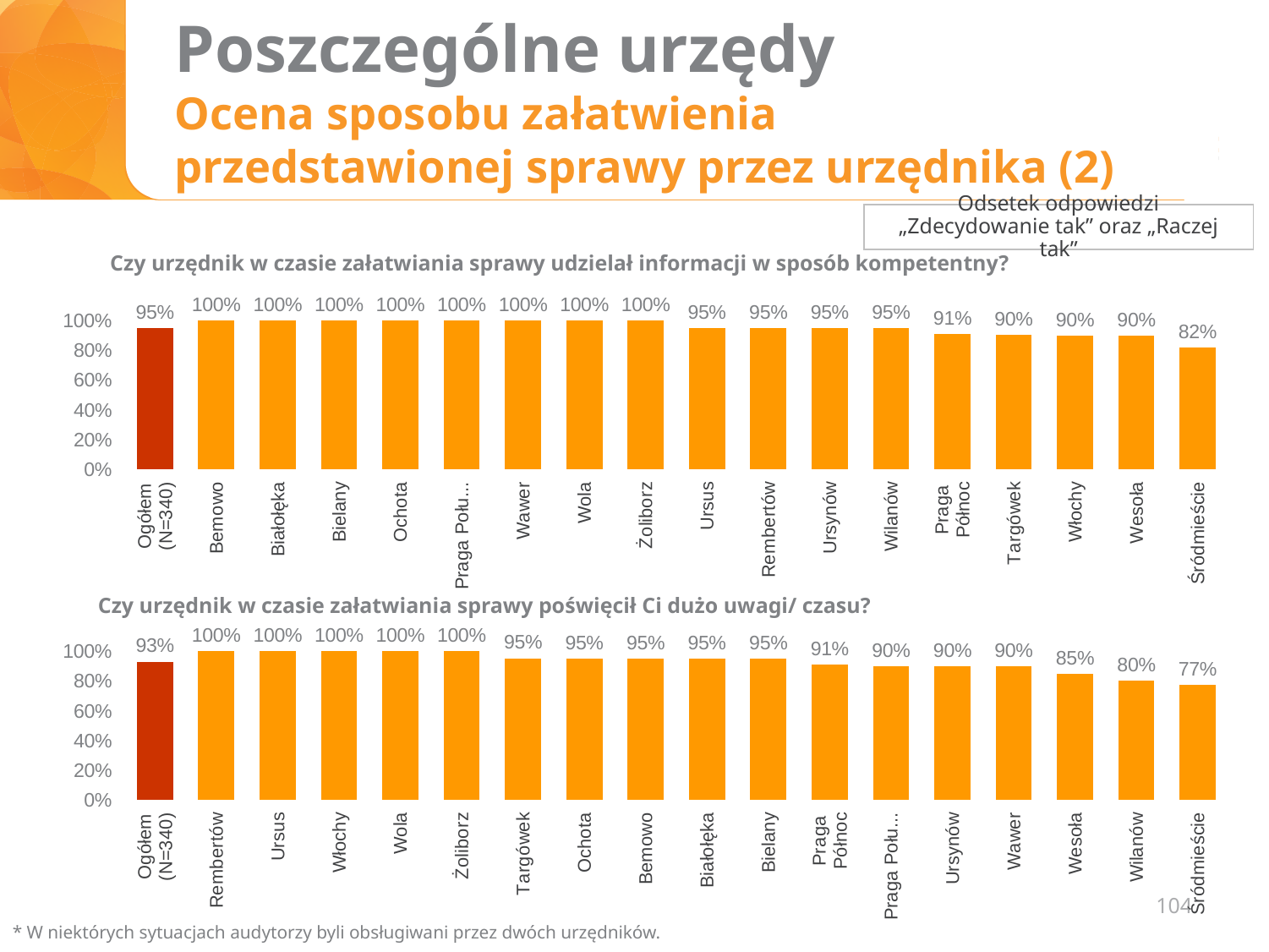
What type of chart is the top chart on the slide? Bar chart In the top chart ("Czy urzędnik w czasie załatwiania sprawy udzielał informacji w sposób kompetentny?"), what is the value for Śródmieście? 82% In the top chart ("Czy urzędnik w czasie załatwiania sprawy udzielał informacji w sposób kompetentny?"), what is the difference between the values for Ursus and Targówek? 5 percentage points In the bottom chart ("Czy urzędnik w czasie załatwiania sprawy poświęcił Ci dużo uwagi/ czasu?"), what is the value for Ogółem (N=340)? 93% In the bottom chart ("Czy urzędnik w czasie załatwiania sprawy poświęcił Ci dużo uwagi/ czasu?"), which is larger, the value for Wesoła or the value for Wilanów? Wesoła In the top chart ("Czy urzędnik w czasie załatwiania sprawy udzielał informacji w sposób kompetentny?"), what is the value for Ogółem (N=340)? 95% In the top chart ("Czy urzędnik w czasie załatwiania sprawy udzielał informacji w sposób kompetentny?"), what is the value for Praga Północ? 91% In the bottom chart ("Czy urzędnik w czasie załatwiania sprawy poświęcił Ci dużo uwagi/ czasu?"), what is the difference between the values for Rembertów and Śródmieście? 23 percentage points In the bottom chart ("Czy urzędnik w czasie załatwiania sprawy poświęcił Ci dużo uwagi/ czasu?"), which category has the lowest value? Śródmieście In the bottom chart ("Czy urzędnik w czasie załatwiania sprawy poświęcił Ci dużo uwagi/ czasu?"), what is the value for Wilanów? 80% In the top chart ("Czy urzędnik w czasie załatwiania sprawy udzielał informacji w sposób kompetentny?"), which category has the lowest value? Śródmieście How many bars are shown in the bottom chart ("Czy urzędnik w czasie załatwiania sprawy poświęcił Ci dużo uwagi/ czasu?")? 18